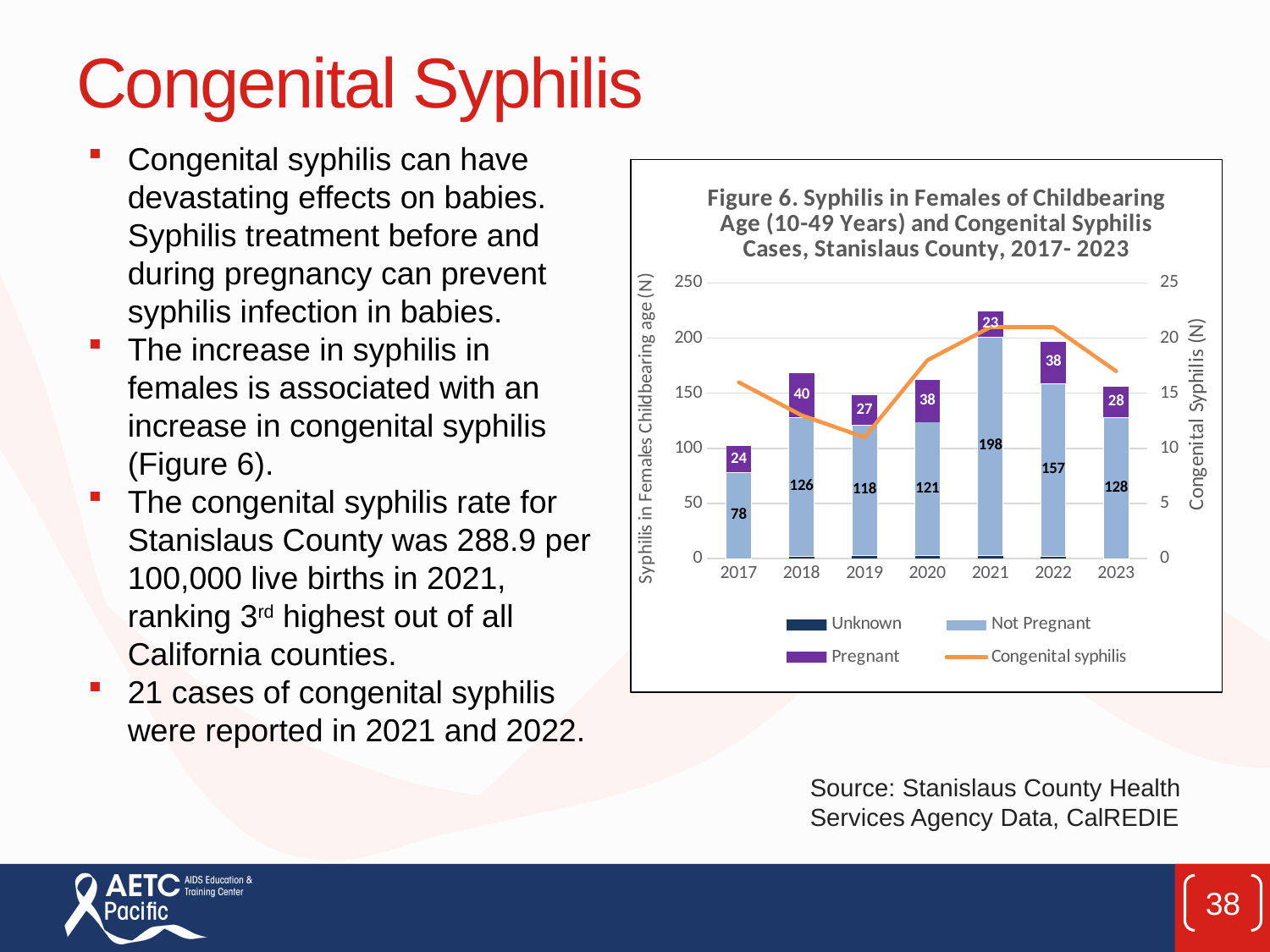
What kind of chart is used for the Not Pregnant, Pregnant and Unknown series? bar chart What is the label of the right-hand vertical axis? Congenital Syphilis (N) What is the Not Pregnant value for 2021? 198 Do the Not Pregnant values rise or fall from 2017 to 2021? rise Which year has the larger Pregnant value, 2018 or 2019? 2018 Which year has the highest Not Pregnant value? 2021 Is the Congenital syphilis value for 2019 greater or less than 15? less What is the difference between the Not Pregnant values for 2021 and 2022? 41 How many series does the legend list? 4 Which year has the lowest Not Pregnant value? 2017 How many years are shown on the x axis? 7 What is the Pregnant value for 2018? 40